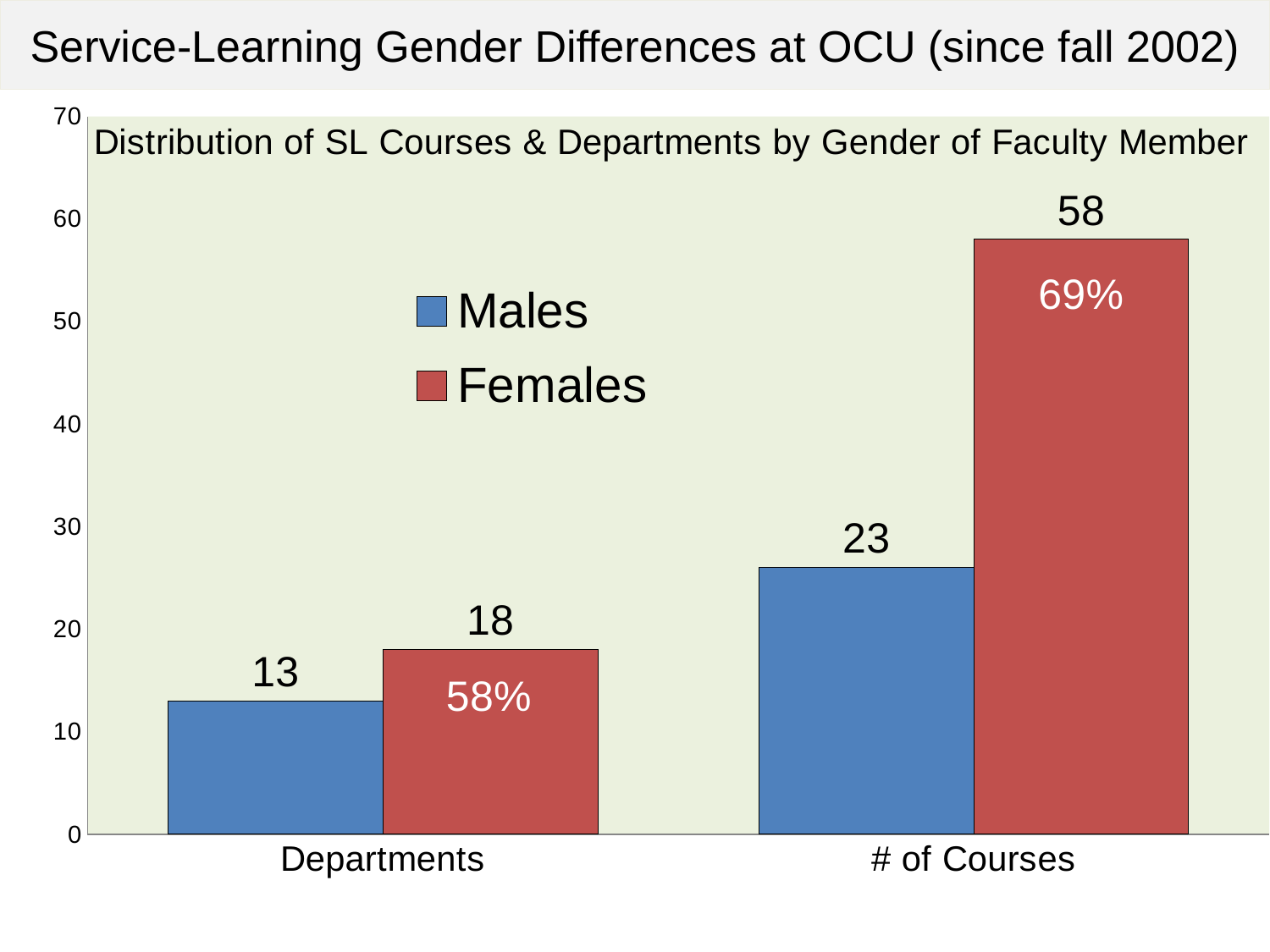
What is the value for Males in the Departments category? 13 What is the value for Males in the # of Courses category? 23 Which series has the highest value in the # of Courses category? Females What percentage label is printed on the Females bar in the # of Courses category? 69% What kind of chart is shown on the slide? Bar chart What is the value for Females in the Departments category? 18 What is the value for Females in the # of Courses category? 58 What is the difference between the Females and Males values in the Departments category? 5 How many categories are shown on the x axis? 2 Which is larger: the Males value for # of Courses or the Females value for Departments? Males value for # of Courses How many series does the legend list? 2 What is the difference between the Females and Males values in the # of Courses category? 35